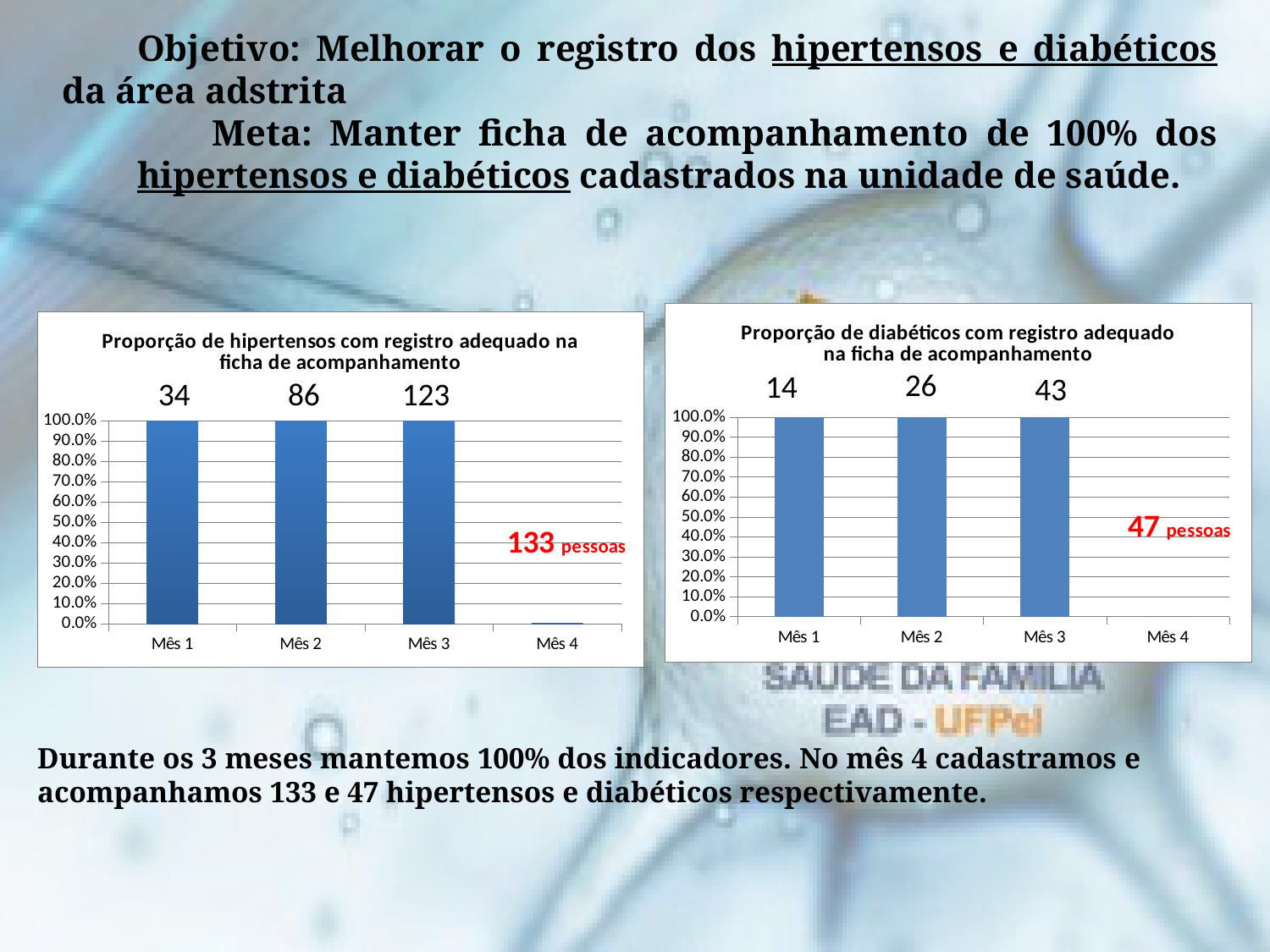
How many categories (months) are shown on the x axis of the right chart, 'Proporção de diabéticos com registro adequado na ficha de acompanhamento'? 4 What number of 'pessoas' is annotated in red on the left chart (hipertensos)? 133 In the left chart (hipertensos), what is the difference between the numbers printed for Mês 3 and Mês 2? 37 In the right chart (diabéticos), what number is printed above the bar for Mês 1? 14 What kind of chart is the left chart, 'Proporção de hipertensos com registro adequado na ficha de acompanhamento'? bar chart In the left chart (hipertensos), what number is printed above the bar for Mês 2? 86 In the left chart (hipertensos), what percentage does the bar for Mês 1 reach on the y axis? 100.0% In the right chart (diabéticos), do the numbers printed above the bars rise or fall from Mês 1 to Mês 3? rise In the right chart (diabéticos), is the value for Mês 4 greater or less than 10.0%? less In the left chart (hipertensos), what number is printed above the bar for Mês 3? 123 In the right chart (diabéticos), what is the difference between the numbers printed for Mês 3 and Mês 2? 17 In the right chart (diabéticos), what number is printed above the bar for Mês 3? 43